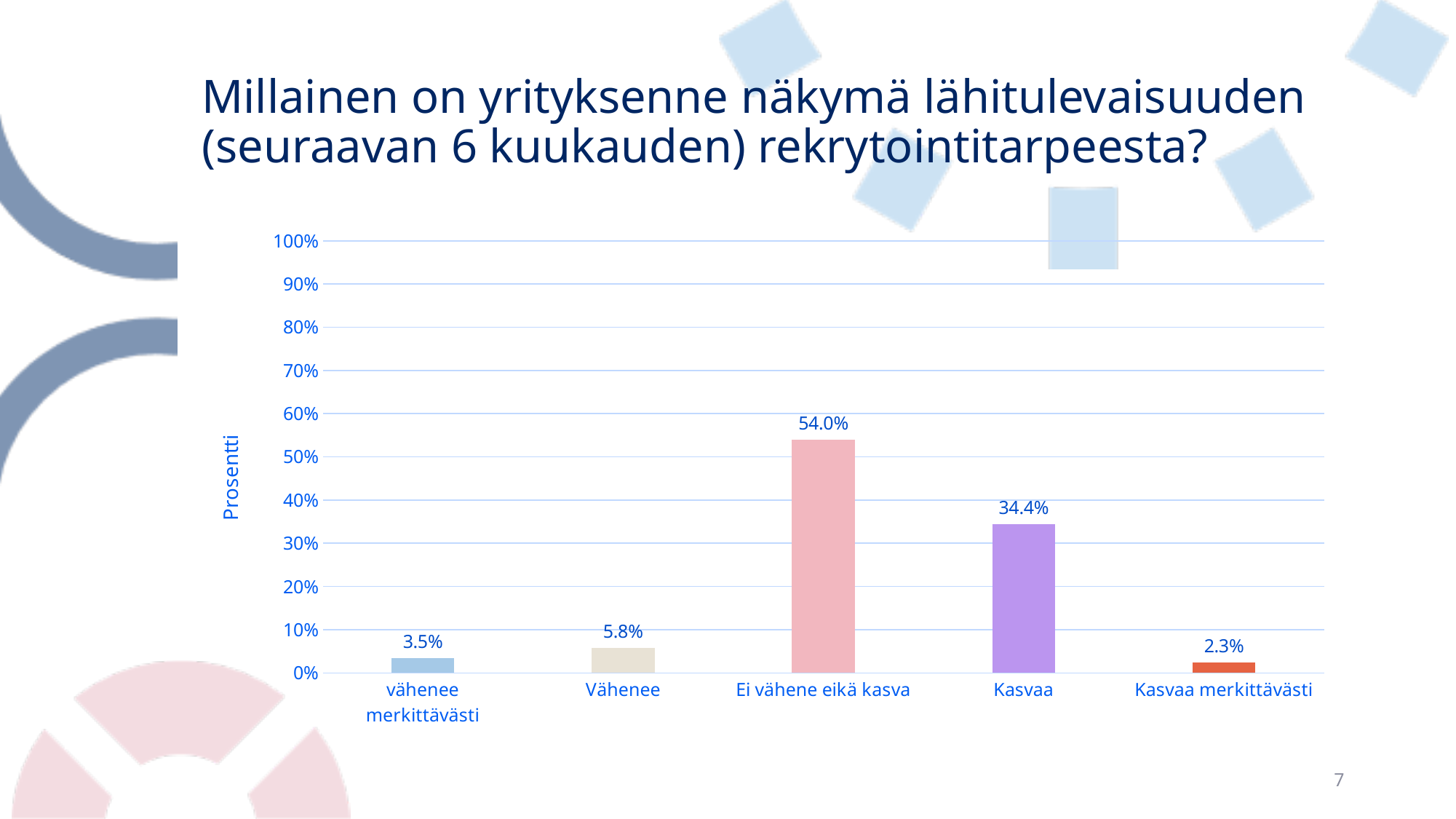
How many categories are shown on the x axis? 5 What kind of chart is shown on the slide? bar chart What is the difference between the values for "Ei vähene eikä kasva" and "Kasvaa"? 19.6% Which is larger, the value for "Vähenee" or the value for "vähenee merkittävästi"? Vähenee What is the value for "Kasvaa"? 34.4% Which category has the highest value? Ei vähene eikä kasva What is the label of the vertical axis? Prosentti Which category has the lowest value? Kasvaa merkittävästi Is the value for "Kasvaa" greater or less than 30%? greater What is the value for "vähenee merkittävästi"? 3.5% What is the value for "Ei vähene eikä kasva"? 54.0% What is the value for "Kasvaa merkittävästi"? 2.3%